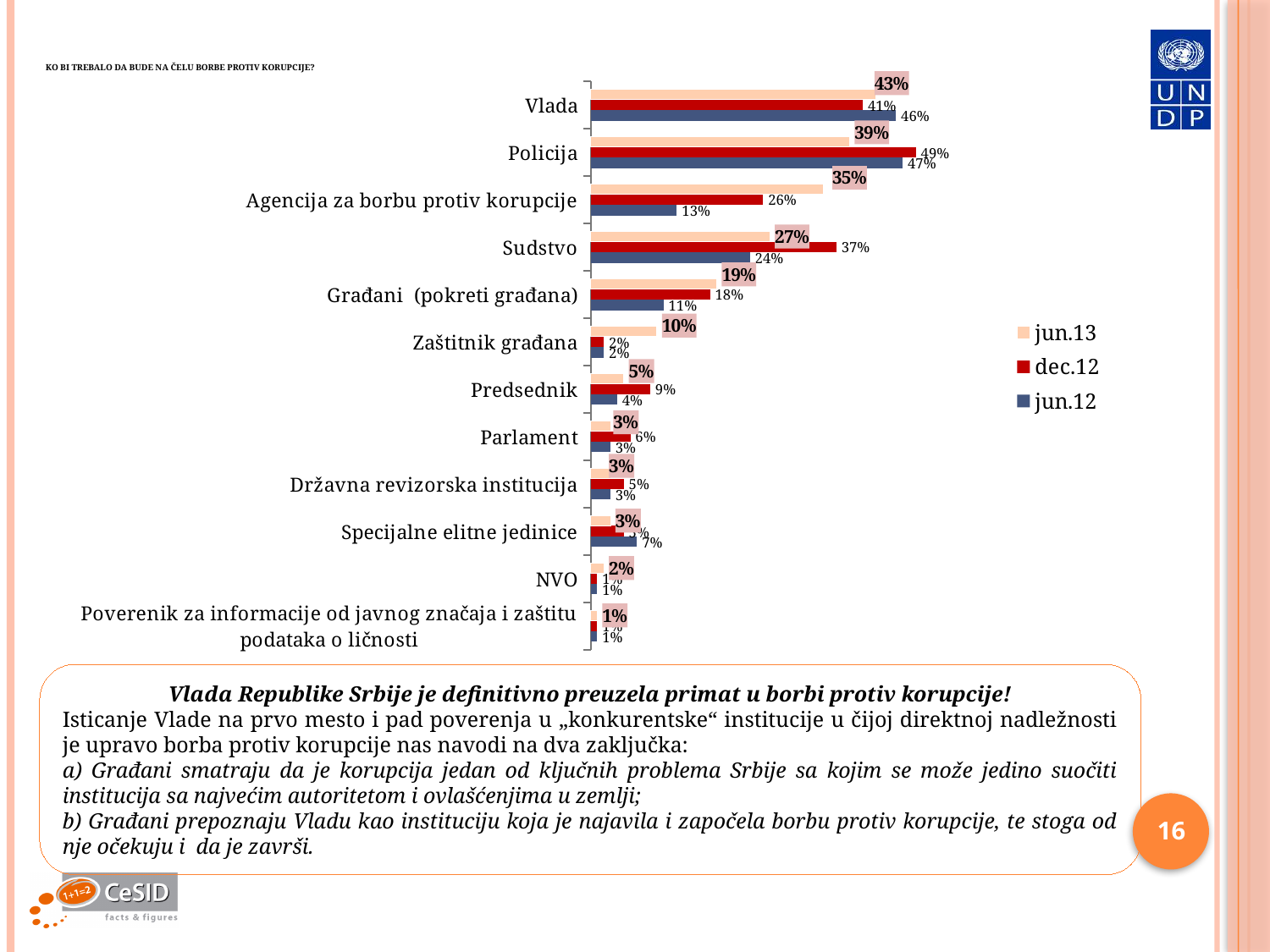
What are the three series listed in the legend? jun.13, dec.12, jun.12 What is the difference between the jun.13 and jun.12 values for Agencija za borbu protiv korupcije? 22% How many series does the legend list? 3 What is the dec.12 value for Policija? 49% What kind of chart is shown on the slide? Bar chart Which category has the highest dec.12 value? Policija How many categories are shown in the chart? 12 What is the jun.12 value for Agencija za borbu protiv korupcije? 13% What is the dec.12 value for Sudstvo? 37% Which category has the highest jun.13 value? Vlada Which is larger for Zaštitnik građana: the jun.13 value or the dec.12 value? jun.13 What is the jun.13 value for Vlada? 43%